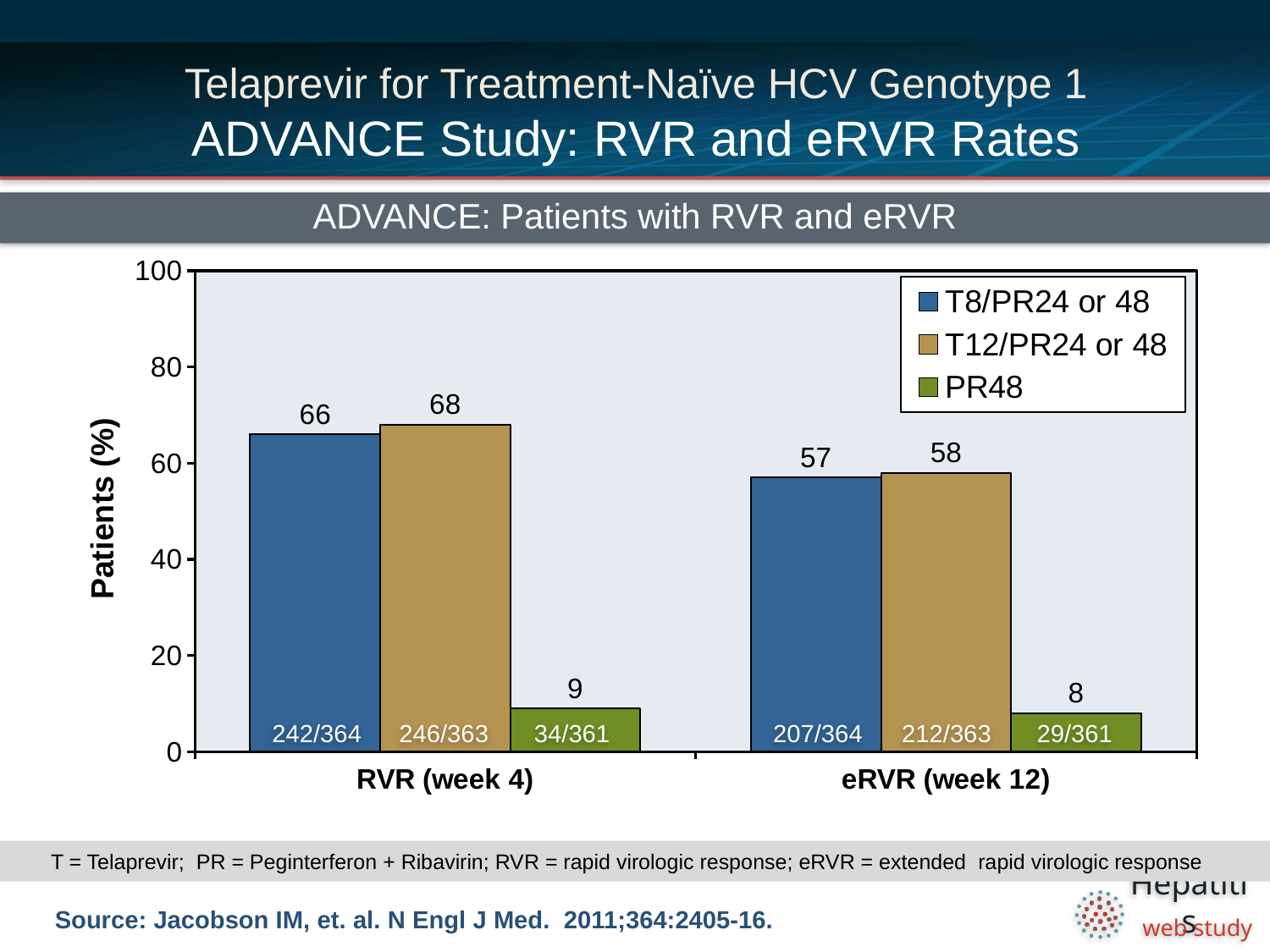
Which series has the highest value in the eRVR (week 12) group? T12/PR24 or 48 Is the value for T12/PR24 or 48 in the RVR (week 4) group greater or less than 60? greater What is the value for PR48 in the eRVR (week 12) group? 8 What is the label of the y axis? Patients (%) What is the difference between the T12/PR24 or 48 value and the PR48 value in the RVR (week 4) group? 59 What is the value for T8/PR24 or 48 in the RVR (week 4) group? 66 Which series has the lowest value in the RVR (week 4) group? PR48 How many categories are shown on the x axis? 2 How many series does the legend list? 3 What is the value for T12/PR24 or 48 in the eRVR (week 12) group? 58 What kind of chart is shown on the slide? Bar chart Which is larger: the T8/PR24 or 48 value for RVR (week 4) or the T8/PR24 or 48 value for eRVR (week 12)? RVR (week 4)